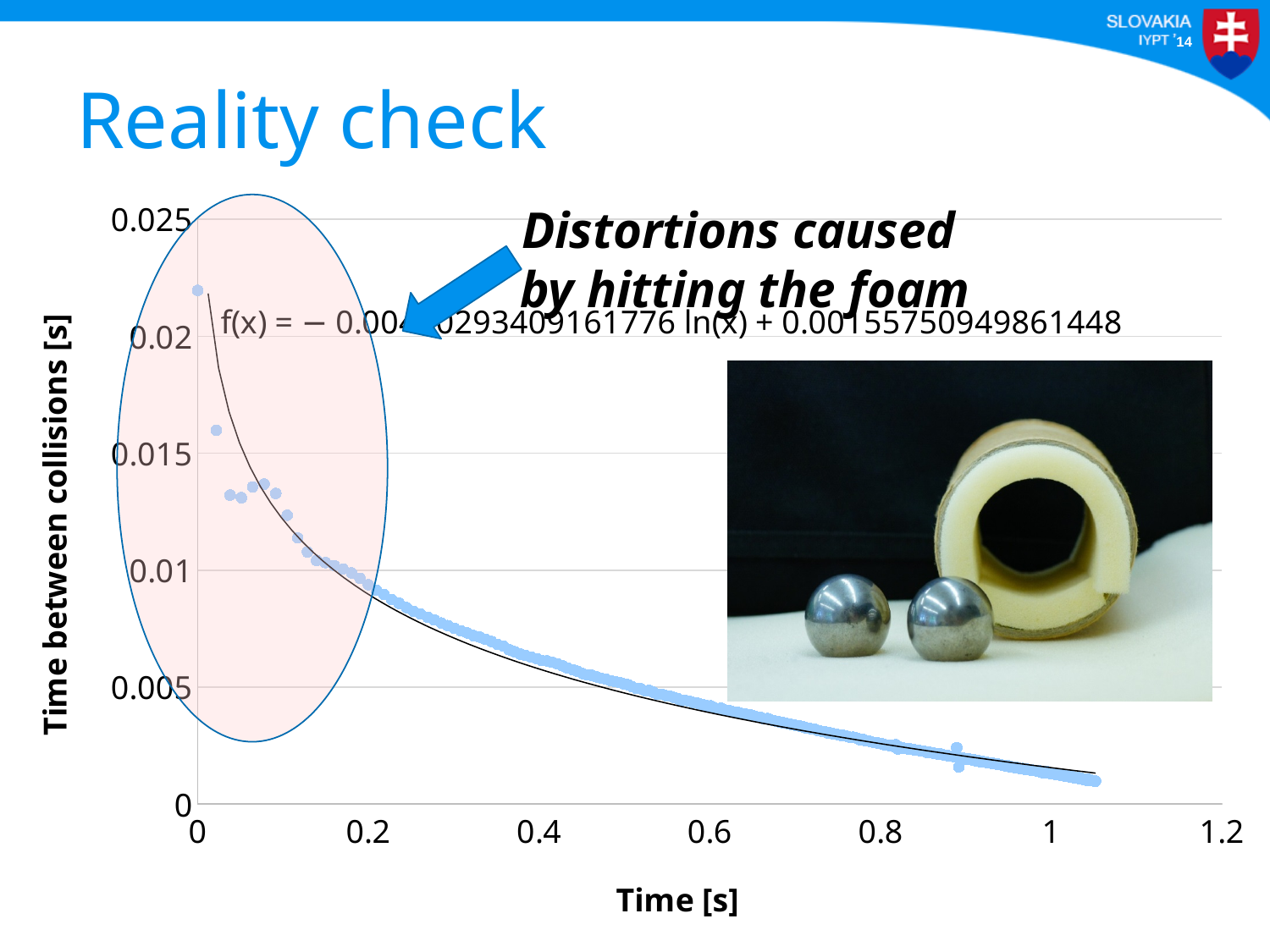
What is the constant term in the fitted function f(x) shown on the chart? 0.00155750949861448 What is the label of the x axis? Time [s] Is the time between collisions at time 0.4 s greater or less than 0.005? greater Is the time between collisions at time 1 s greater or less than 0.005? less What is the label of the y axis? Time between collisions [s] Is the time between collisions at time 0.4 s greater or less than 0.01? less What kind of chart is shown on the slide? scatter chart Do the plotted values rise or fall as time increases along the x axis? fall What is the highest tick value shown on the x axis? 1.2 What is the highest tick value shown on the y axis? 0.025